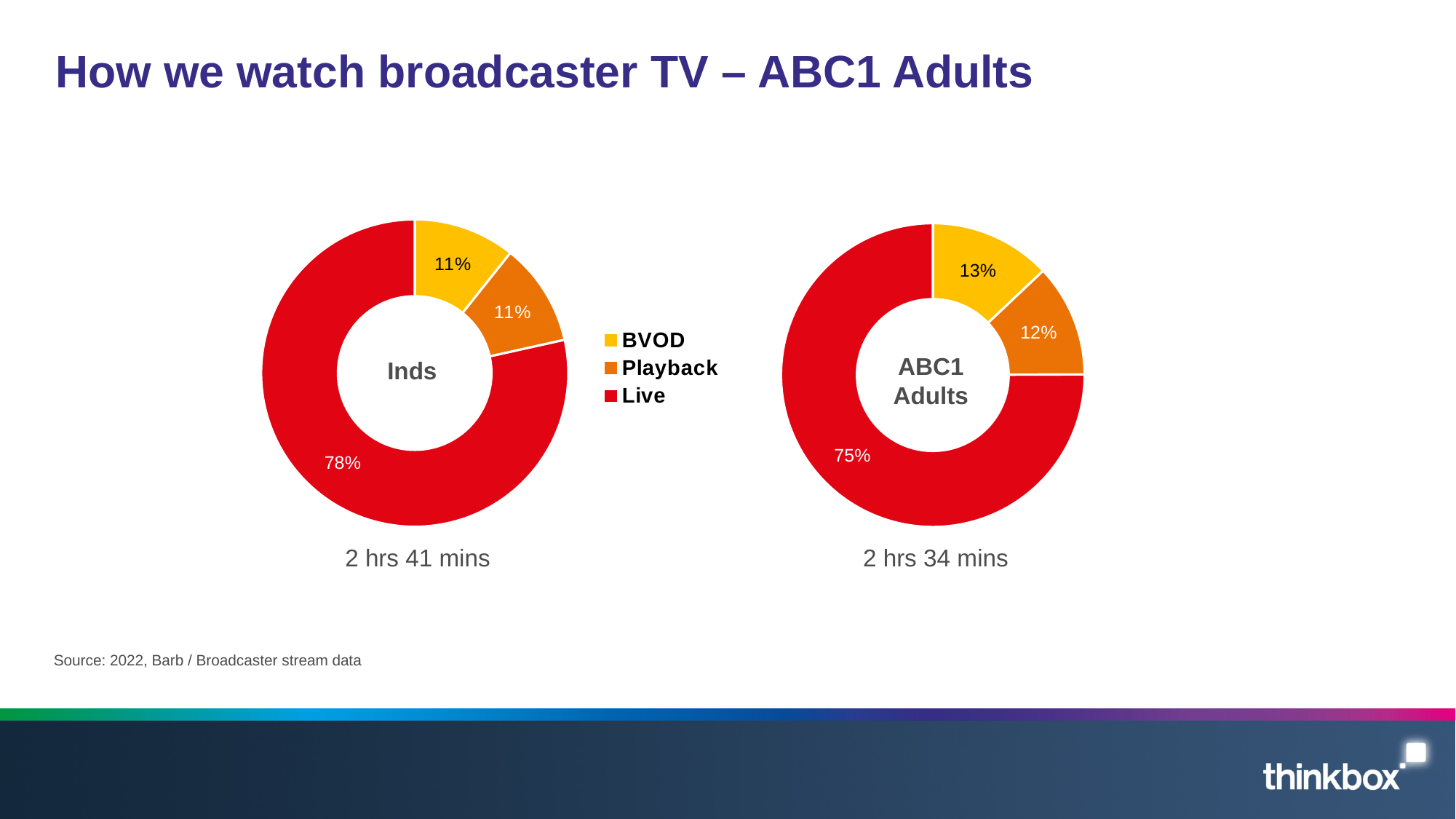
In the ABC1 Adults chart, what share of viewing is Playback? 12% How many categories does each donut chart show? 3 In the Inds chart, what share of viewing is BVOD? 11% In the Inds chart, which category has the largest share? Live Is the BVOD share larger in the Inds chart or the ABC1 Adults chart? ABC1 Adults What kind of chart is used on this slide? Donut (pie) chart What is the difference between the Live share in the Inds chart and the Live share in the ABC1 Adults chart? 3 percentage points What total viewing time is shown beneath the ABC1 Adults chart? 2 hrs 34 mins In the ABC1 Adults chart, what share of viewing is BVOD? 13% How many entries does the legend list? 3 In the Inds chart, what share of viewing is Live? 78% In the ABC1 Adults chart, which category has the largest share? Live